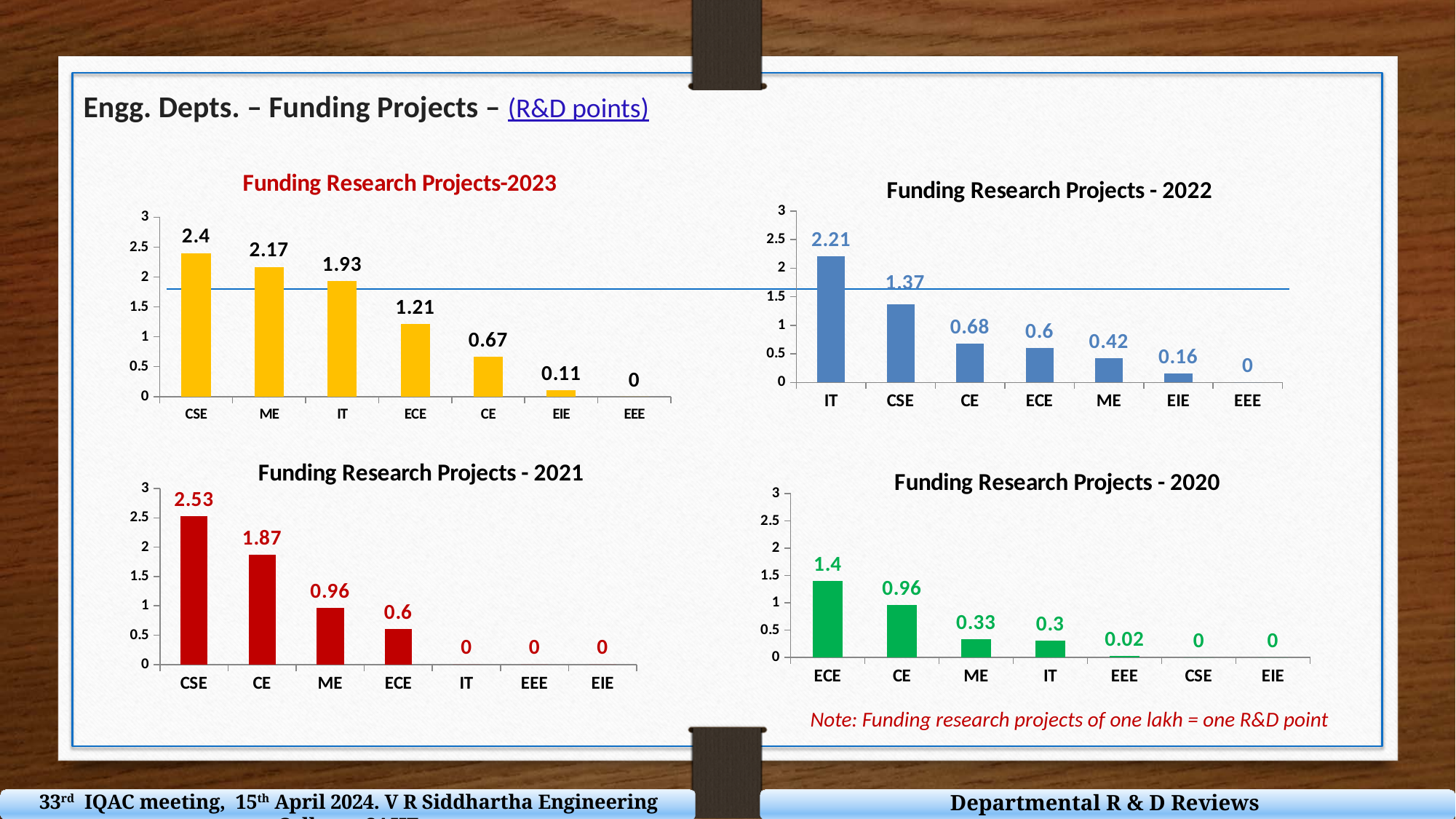
What colour are the bars in the 'Funding Research Projects - 2021' chart? Red In the 'Funding Research Projects - 2021' chart, how many departments are shown on the x axis? 7 In the 'Funding Research Projects-2023' chart, what is the value for CSE? 2.4 In the 'Funding Research Projects - 2022' chart, what is the difference between the values for IT and CSE? 0.84 In the 'Funding Research Projects - 2020' chart, what is the value for EEE? 0.02 In the 'Funding Research Projects - 2021' chart, what is the value for ME? 0.96 In the 'Funding Research Projects - 2022' chart, which department has the highest value? IT In the 'Funding Research Projects-2023' chart, do the values rise or fall from left to right along the x axis? Fall In the 'Funding Research Projects - 2020' chart, which department has the highest value? ECE In the 'Funding Research Projects - 2022' chart, which is larger, the value for CE or the value for ECE? CE What type of chart is 'Funding Research Projects - 2020'? Bar chart In the 'Funding Research Projects-2023' chart, what is the difference between the values for CSE and ME? 0.23